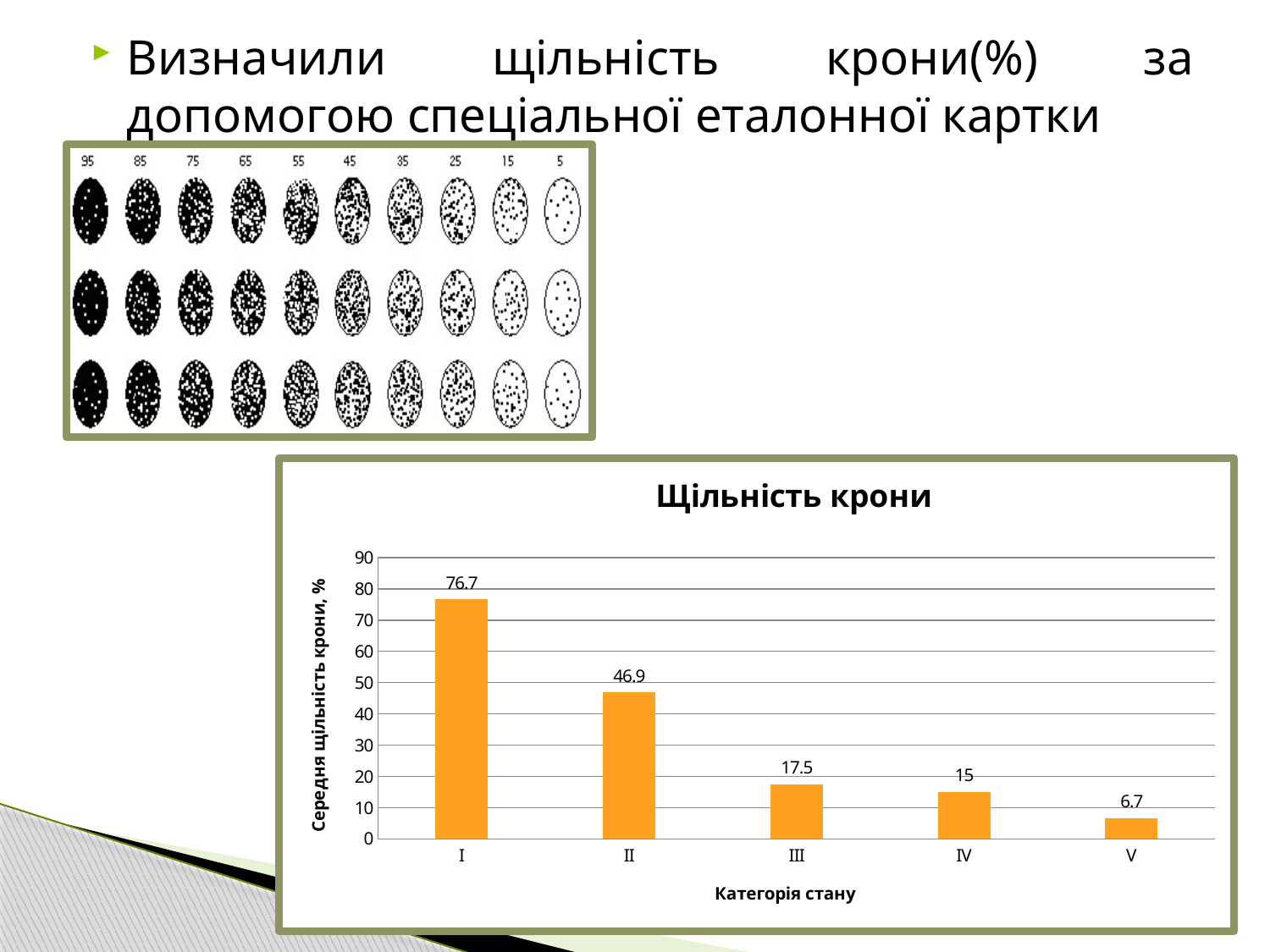
What is the value for category I in the chart? 76.7 Do the values rise or fall from category I to category V? fall What is the value for category III in the chart? 17.5 Is the value for category II greater or less than 50? less How many categories are shown on the x axis of the chart? 5 What is the difference between the values for category III and category IV? 2.5 Which category has the lowest value in the chart? V What is the value for category V in the chart? 6.7 Which category has the highest value in the chart? I What is the difference between the values for category I and category II? 29.8 What kind of chart is shown on the slide? bar chart Which is larger, the value for category II or the value for category IV? II